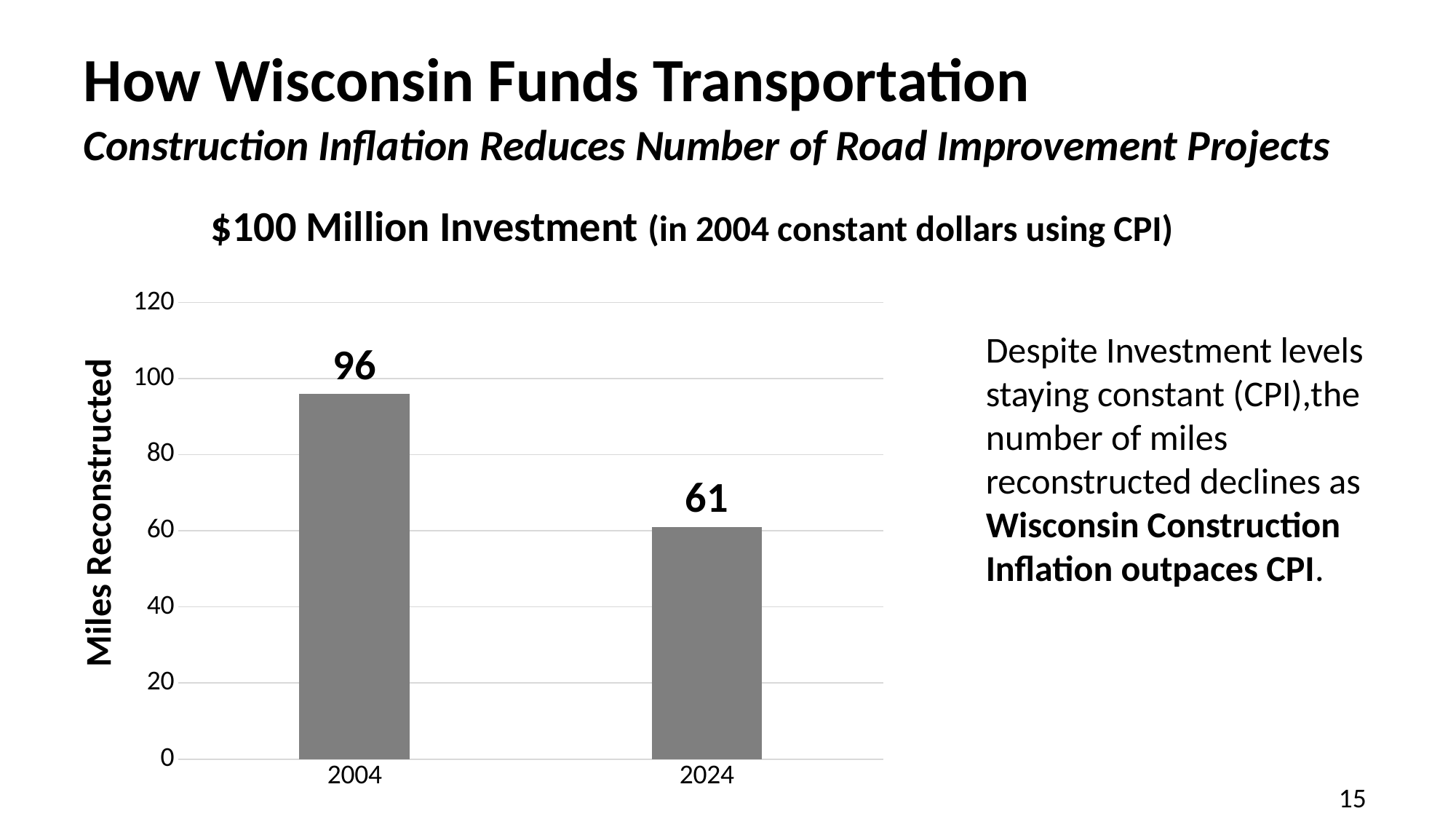
What is the label of the vertical axis of the chart? Miles Reconstructed Which is larger, the value for 2004 or the value for 2024? 2004 What is the difference between the miles reconstructed in 2004 and in 2024? 35 Is the value for 2004 greater or less than 80? greater What is the value for 2004 in the chart? 96 Which year has the highest number of miles reconstructed? 2004 Which year has the lowest number of miles reconstructed? 2024 Do the values rise or fall from 2004 to 2024? fall What kind of chart is shown on the slide? bar chart How many bars are shown in the chart? 2 What is the value for 2024 in the chart? 61 Is the value for 2024 greater or less than 80? less